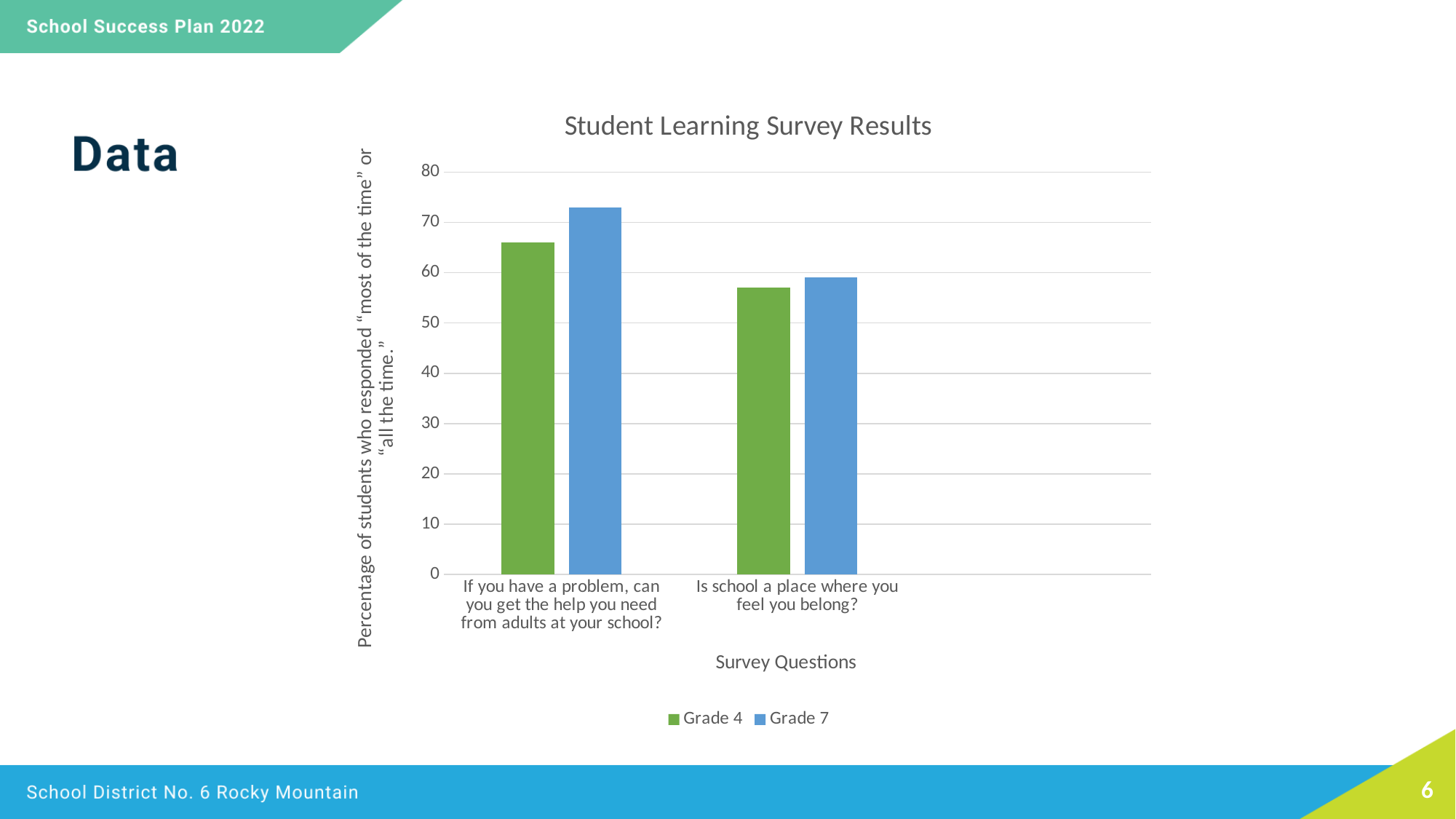
For the question "If you have a problem, can you get the help you need from adults at your school?", which grade has the higher value? Grade 7 What is the title of the chart? Student Learning Survey Results Do the Grade 4 values rise or fall from the first survey question to the second? fall Is the Grade 4 value for "Is school a place where you feel you belong?" greater or less than 60? less How many series does the legend list? 2 Is the Grade 7 value for "Is school a place where you feel you belong?" greater or less than 50? greater Is the Grade 7 value for "If you have a problem, can you get the help you need from adults at your school?" greater or less than 70? greater Which bar is the highest in the chart? Grade 7, "If you have a problem, can you get the help you need from adults at your school?" How many survey questions are shown on the x axis? 2 Which series is shown in green? Grade 4 What type of chart is shown on the slide? bar chart